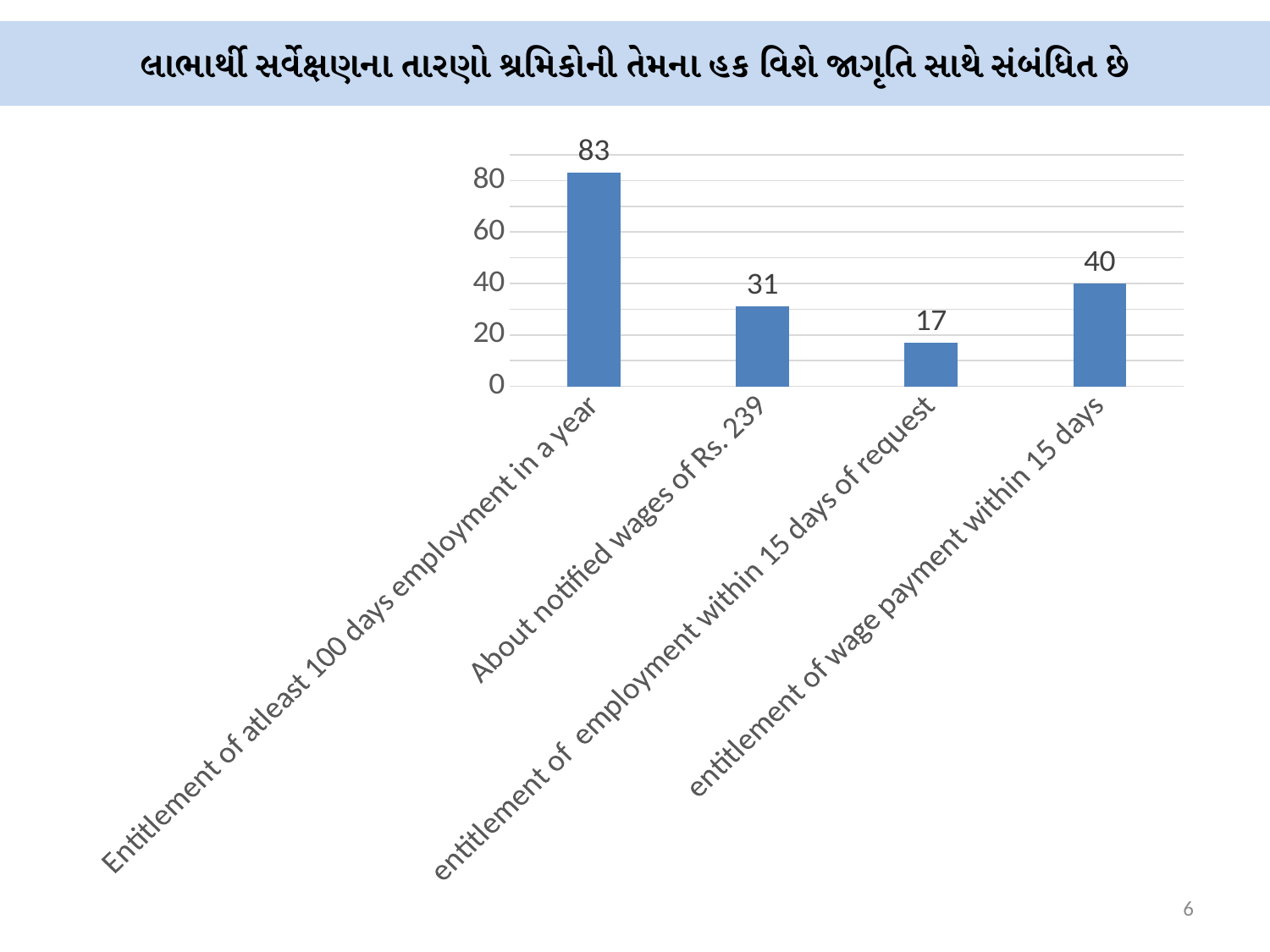
Is the value for 'About notified wages of Rs. 239' greater or less than 40? less Which category has the lowest value? entitlement of employment within 15 days of request What is the value for 'entitlement of employment within 15 days of request'? 17 What is the difference between the values for 'Entitlement of atleast 100 days employment in a year' and 'entitlement of wage payment within 15 days'? 43 Which is larger: the value for 'About notified wages of Rs. 239' or the value for 'entitlement of wage payment within 15 days'? entitlement of wage payment within 15 days What is the value for 'About notified wages of Rs. 239'? 31 How many categories are shown in the chart? 4 What is the difference between the values for 'About notified wages of Rs. 239' and 'entitlement of employment within 15 days of request'? 14 Which category has the highest value? Entitlement of atleast 100 days employment in a year What is the value for 'Entitlement of atleast 100 days employment in a year'? 83 What kind of chart is shown on the slide? bar chart What is the value for 'entitlement of wage payment within 15 days'? 40